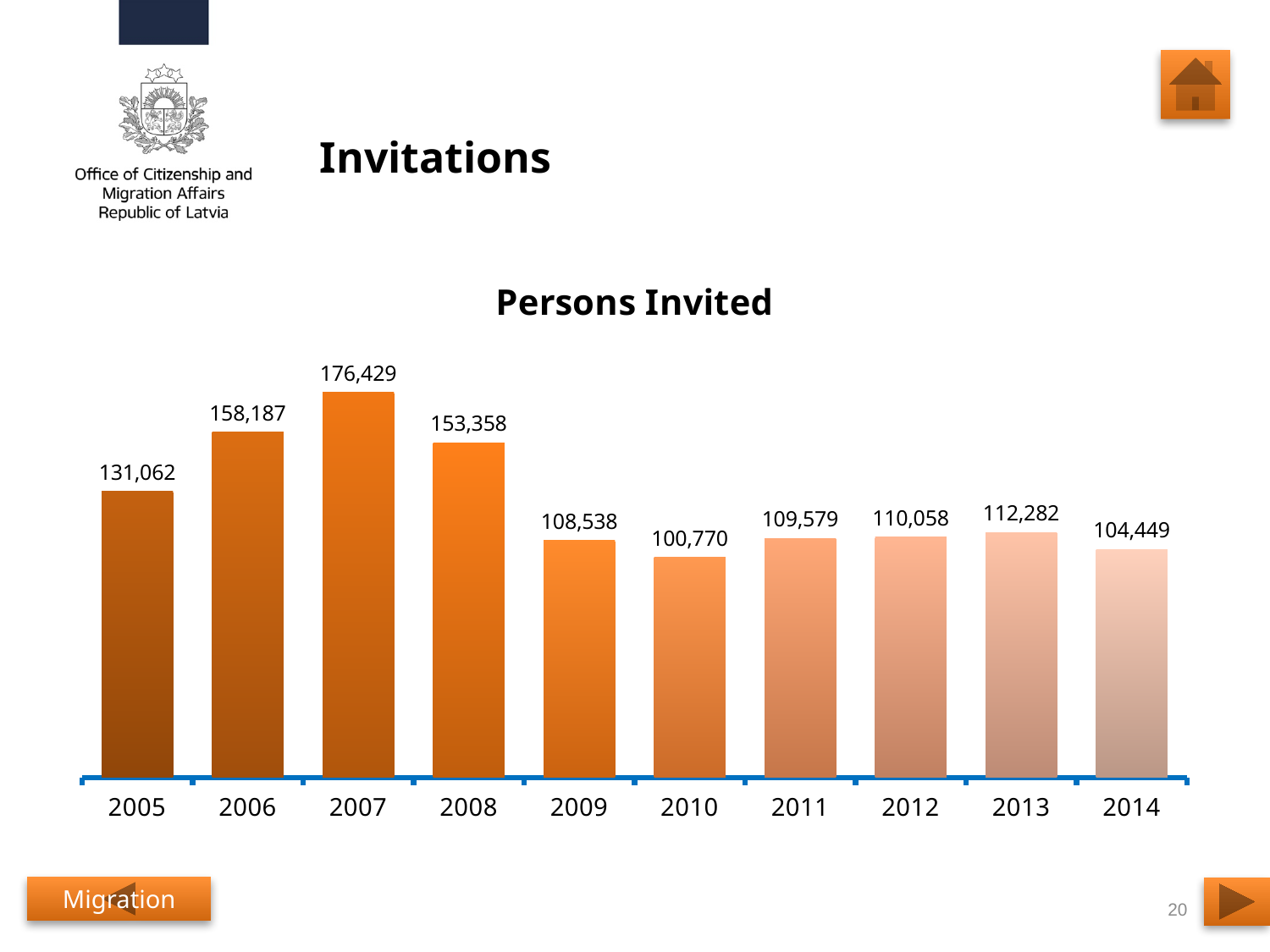
What is the difference between the values for 2006 and 2005? 27,125 What is the difference between the values for 2007 and 2008? 23,071 Which year has the lowest number of persons invited? 2010 Which is larger, the value for 2013 or the value for 2009? 2013 What kind of chart is used to show Persons Invited? Bar chart Do the values rise or fall from 2007 to 2010? Fall What is the value for 2007 in the Persons Invited chart? 176,429 Which year has the highest number of persons invited? 2007 How many years are shown on the x axis of the chart? 10 How many persons were invited in 2010? 100,770 What is the title of the chart? Persons Invited What is the value shown for 2014? 104,449